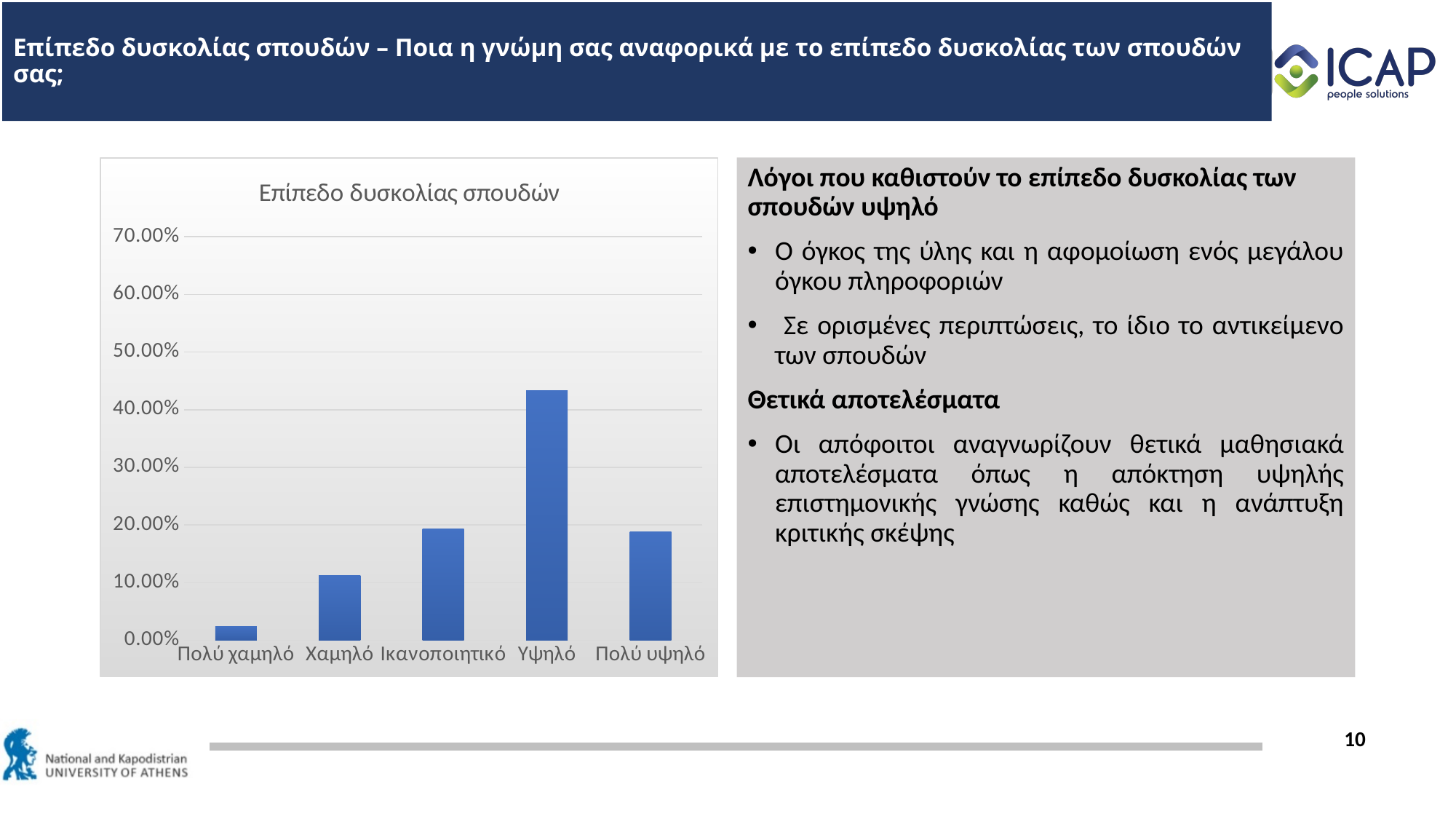
How many categories are shown on the x axis of the chart? 5 Is the value for Χαμηλό greater or less than 10.00%? greater Is the value for Πολύ χαμηλό greater or less than 10.00%? less What is the title of the chart? Επίπεδο δυσκολίας σπουδών Which is larger, the value for Πολύ χαμηλό or the value for Πολύ υψηλό? Πολύ υψηλό What type of chart is shown on the slide? bar chart Is the value for Υψηλό greater or less than 40.00%? greater Which category has the highest value in the chart? Υψηλό Which category has the lowest value in the chart? Πολύ χαμηλό Which is larger, the value for Χαμηλό or the value for Υψηλό? Υψηλό